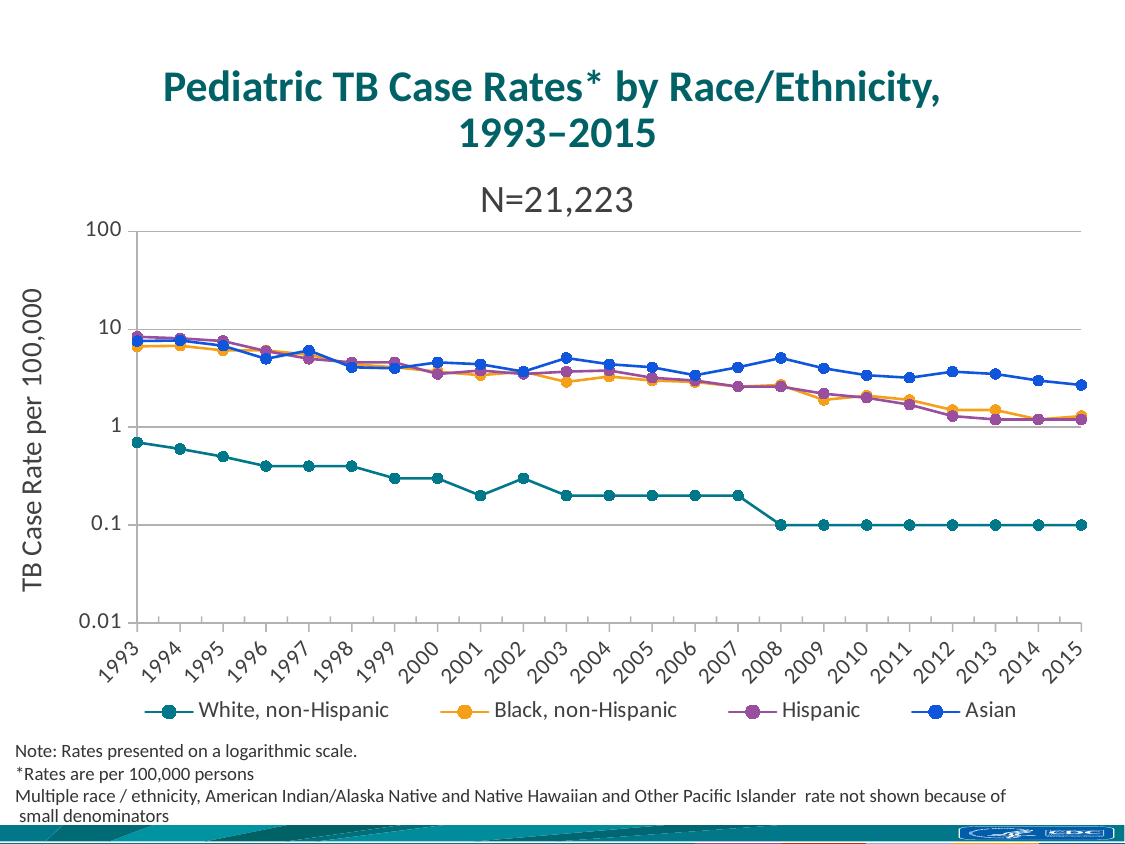
Is the TB case rate for Asian in 2015 greater or less than 1? greater Does the TB case rate for White, non-Hispanic rise or fall from 1993 to 2015? fall How many years are plotted along the x axis? 23 Which race/ethnicity group has the lowest TB case rate in 2015? White, non-Hispanic What is the N value shown above the chart? N=21,223 What is the label on the y axis? TB Case Rate per 100,000 What kind of chart is shown on the slide? line chart Is the TB case rate for Hispanic in 1993 greater or less than 10? less How many series does the legend list? 4 Which race/ethnicity group has the highest TB case rate in 2015? Asian Which is larger in 2015, the TB case rate for Asian or for White, non-Hispanic? Asian Is the TB case rate for White, non-Hispanic in 1993 greater or less than 1? less